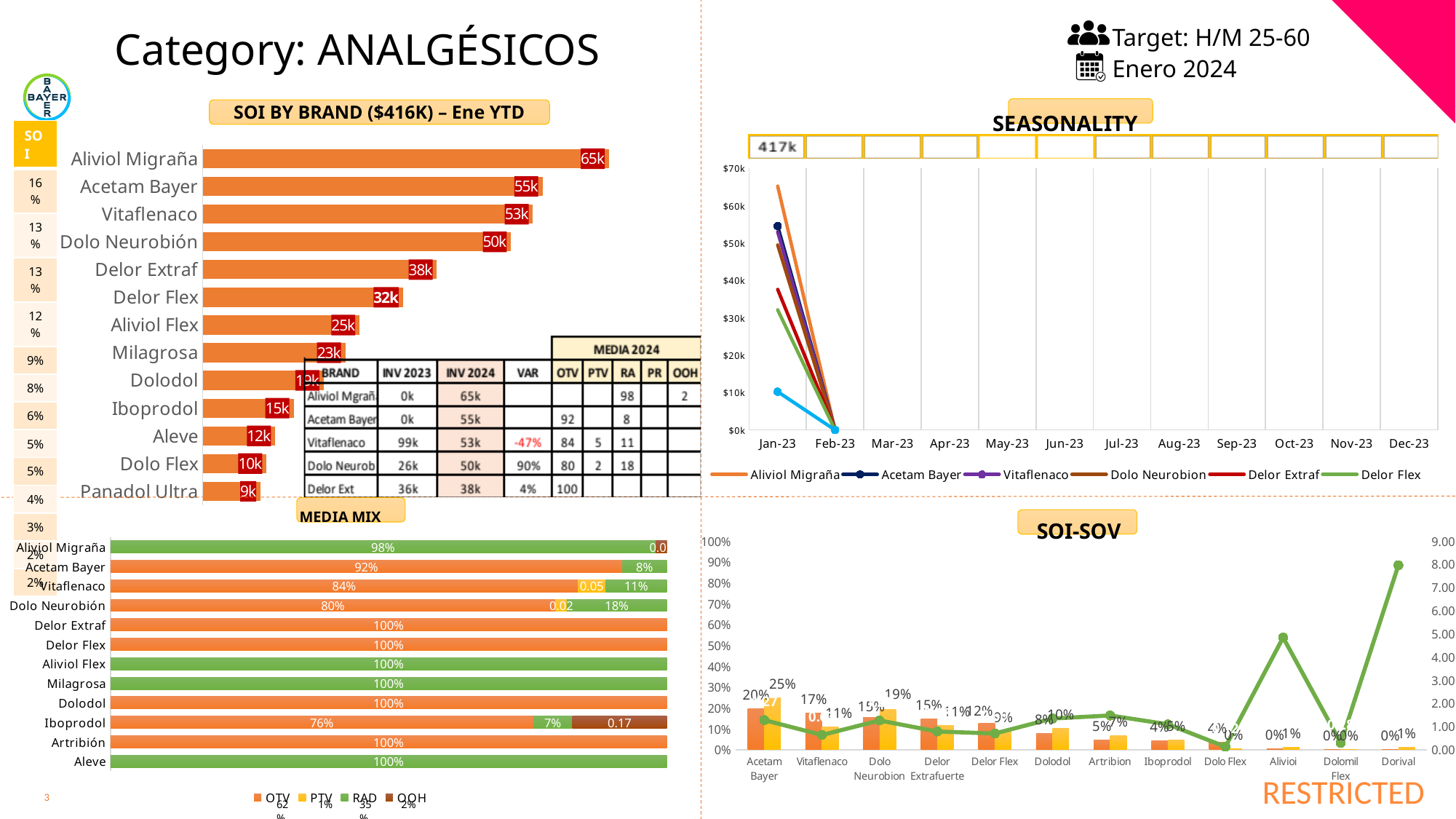
In the SOI BY BRAND chart, what is the value for Aliviol Migraña? 65k In the SOI-SOV chart, what is the value of the orange bar for Vitaflenaco? 17% In the MEDIA MIX chart, what is the OTV share for Acetam Bayer? 92% In the SOI BY BRAND chart, which brand has the lowest value? Panadol Ultra How many series does the legend of the SEASONALITY chart list? 6 What kind of chart is the SEASONALITY chart? Line chart How many brands are shown in the SOI BY BRAND chart? 13 In the SEASONALITY chart, do the lines rise or fall from Jan-23 to Feb-23? Fall In the SOI BY BRAND chart, which is larger, Delor Extraf or Delor Flex? Delor Extraf How many series does the legend of the MEDIA MIX chart list? 4 In the SOI BY BRAND chart, what is the difference between Acetam Bayer and Vitaflenaco? 2k In the SEASONALITY chart, is the Jan-23 value for Aliviol Migraña greater or less than $60k? greater